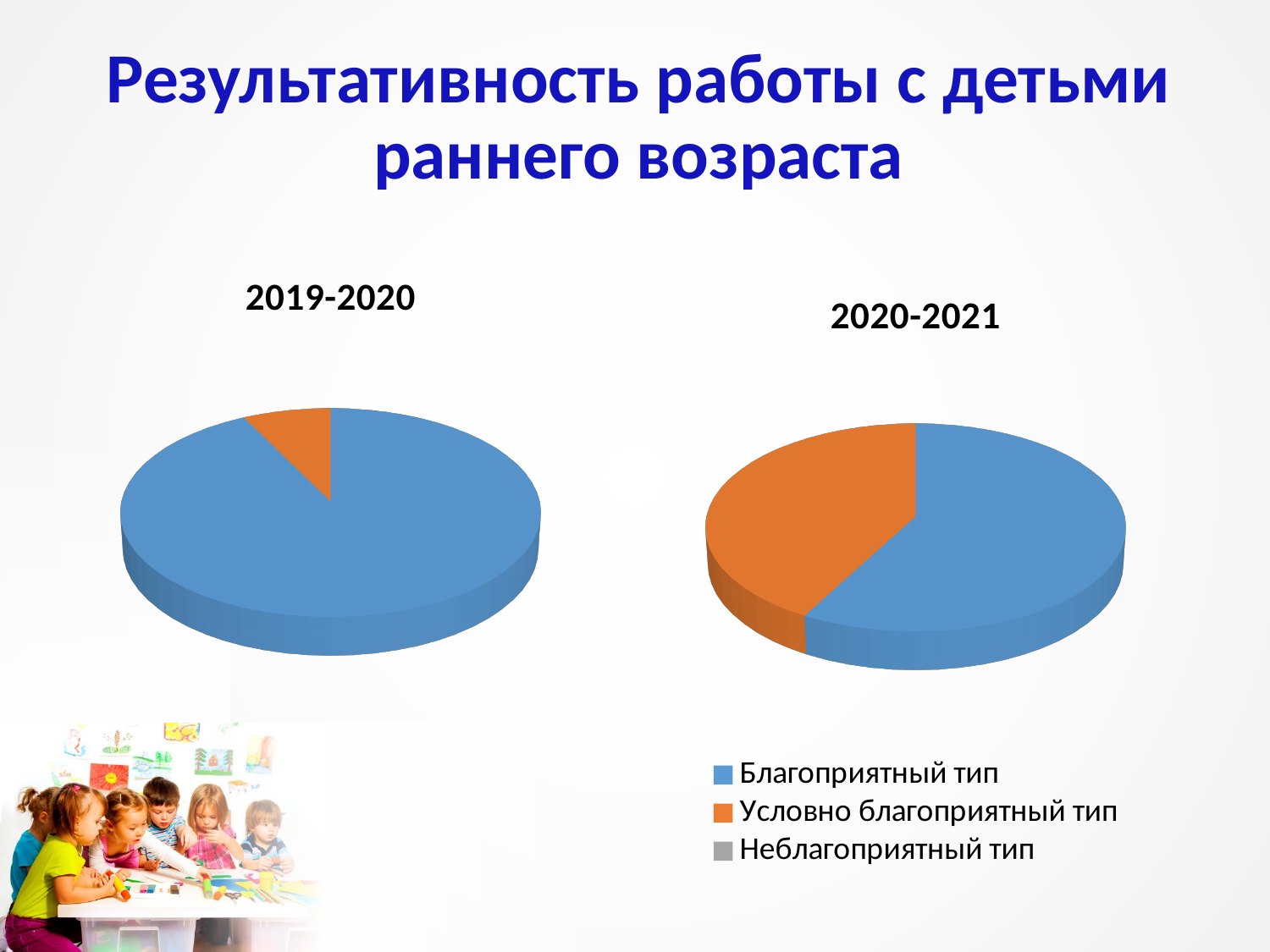
In the "2019-2020" chart, which category has the largest slice? Благоприятный тип What colour represents Условно благоприятный тип in the legend? orange What kind of chart is the "2019-2020" chart? pie chart What kind of chart is the "2020-2021" chart? pie chart Which chart has the larger Условно благоприятный тип slice, "2019-2020" or "2020-2021"? 2020-2021 How many slices are visible in the "2020-2021" pie chart? 2 How many categories does the legend list for the pie charts? 3 In the "2020-2021" chart, which slice is larger, Благоприятный тип or Условно благоприятный тип? Благоприятный тип How many slices are visible in the "2019-2020" pie chart? 2 What is the title of the pie chart on the left? 2019-2020 In the "2020-2021" chart, which category has the largest slice? Благоприятный тип